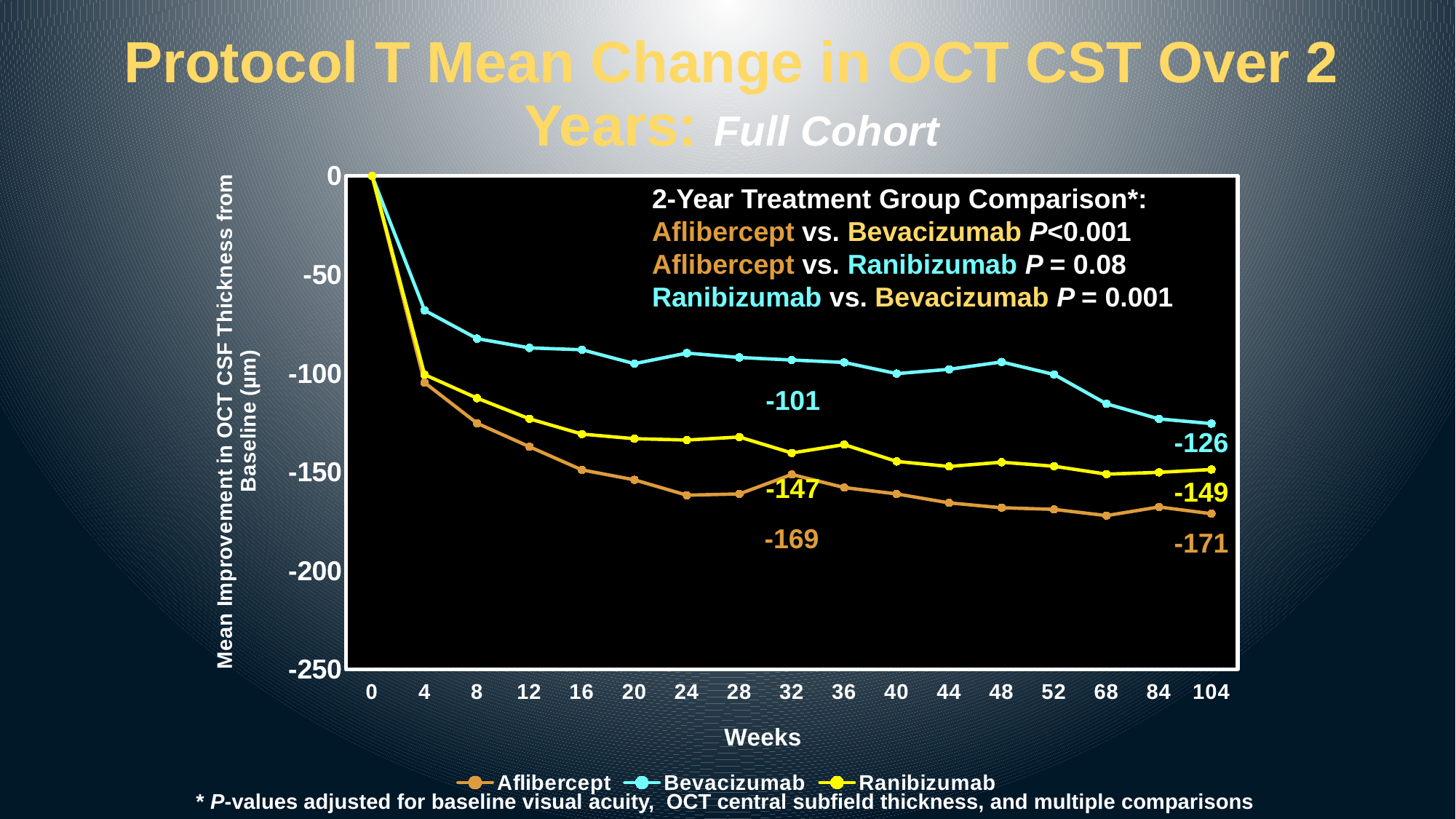
Which series has the highest (least negative) value at week 104? Bevacizumab Do the values for all three series rise or fall from week 0 to week 104? fall What is the value for Ranibizumab at week 104? -149 What kind of chart is shown on the slide? line chart Is the value for Bevacizumab at week 4 greater or less than -50? less What is the value for Aflibercept at week 104? -171 What is the difference between the Bevacizumab and Aflibercept values at week 104? 45 What is the difference between the Ranibizumab and Aflibercept values at week 104? 22 How many week points are shown on the x axis? 17 How many series does the legend list? 3 Which series has the lowest (most negative) value at week 104? Aflibercept What is the value for Bevacizumab at week 104? -126